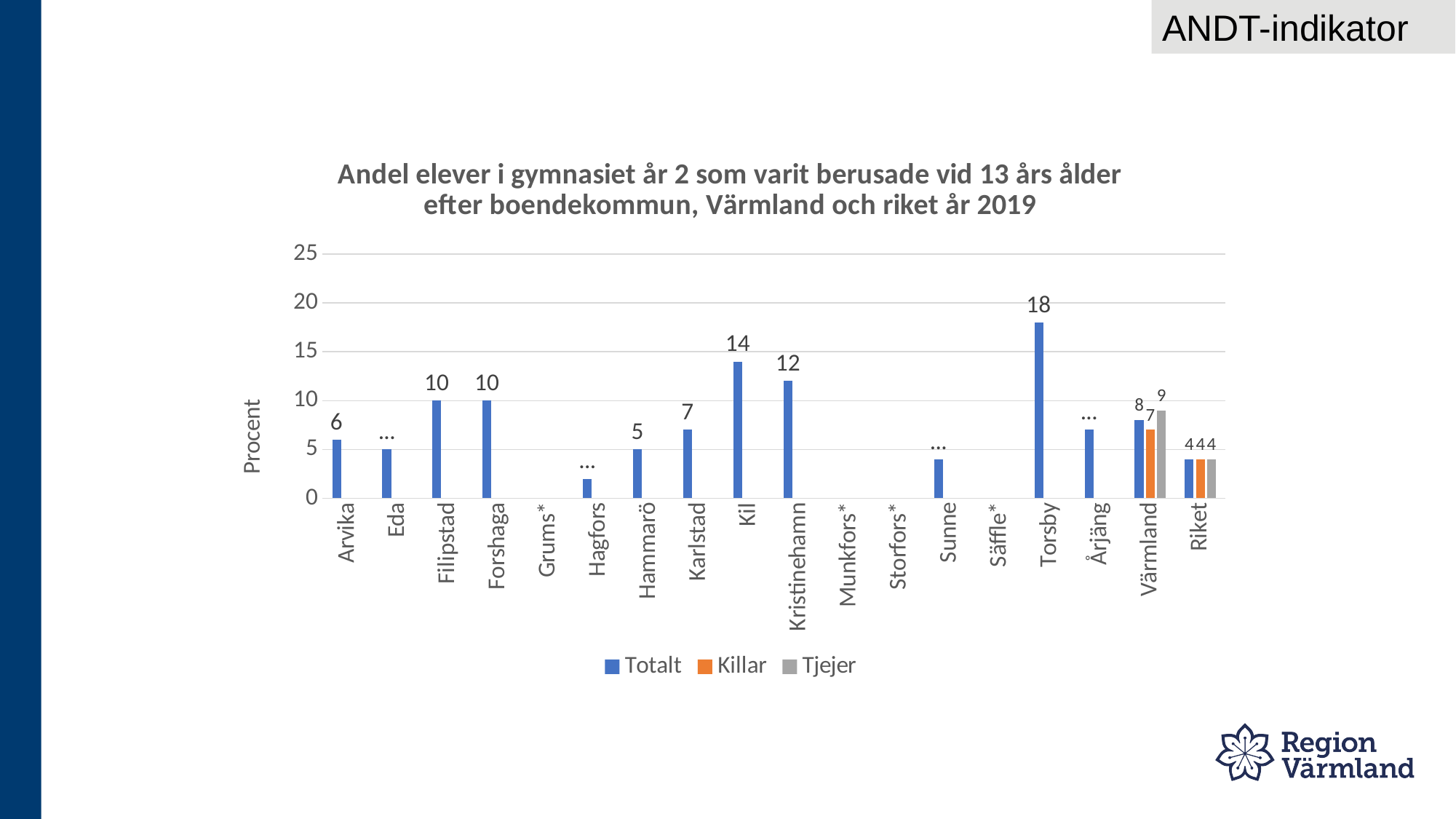
Which has a higher Totalt value, Filipstad or Karlstad? Filipstad Which municipality has the highest Totalt value? Torsby What is the difference between the Totalt values for Kil and Kristinehamn? 2 What kind of chart is shown on the slide? bar chart How many series does the legend list? 3 What is the Totalt value for Kil? 14 What is the Totalt value for Torsby? 18 Is the Totalt value for Hagfors greater or less than 5? less How many categories are shown on the x axis? 18 What is the difference between the Totalt values for Torsby and Arvika? 12 What is the Killar value for Riket? 4 What is the Tjejer value for Värmland? 9